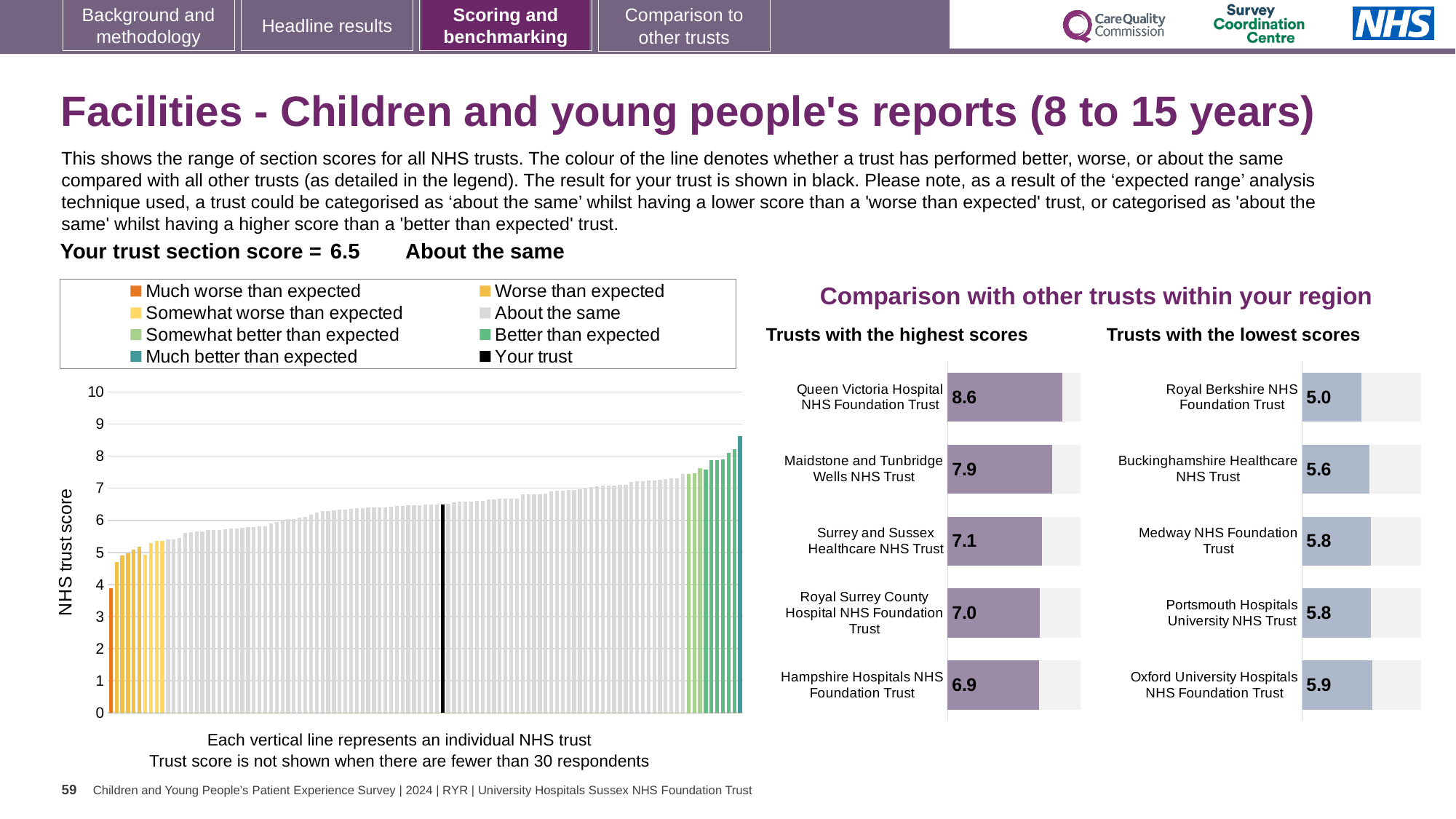
In the large chart on the left, is the value for the black bar (Your trust) greater or less than 6? greater In the 'Trusts with the highest scores' chart, which trust has the highest score? Queen Victoria Hospital NHS Foundation Trust In the 'Trusts with the highest scores' chart, what is the difference between the scores of Queen Victoria Hospital NHS Foundation Trust and Maidstone and Tunbridge Wells NHS Trust? 0.7 In the 'Trusts with the lowest scores' chart, which has the higher score: Medway NHS Foundation Trust or Oxford University Hospitals NHS Foundation Trust? Oxford University Hospitals NHS Foundation Trust How many trusts are shown in the 'Trusts with the lowest scores' chart? 5 In the large chart on the left, do the NHS trust scores rise or fall from left to right? Rise What kind of chart is the large chart on the left showing NHS trust scores? Bar chart How many entries does the legend above the large chart on the left list? 8 In the 'Trusts with the highest scores' chart, what is the score for Hampshire Hospitals NHS Foundation Trust? 6.9 In the 'Trusts with the lowest scores' chart, which trust has the lowest score? Royal Berkshire NHS Foundation Trust In the 'Trusts with the lowest scores' chart, what is the score for Royal Berkshire NHS Foundation Trust? 5.0 In the 'Trusts with the highest scores' chart, what is the score for Queen Victoria Hospital NHS Foundation Trust? 8.6